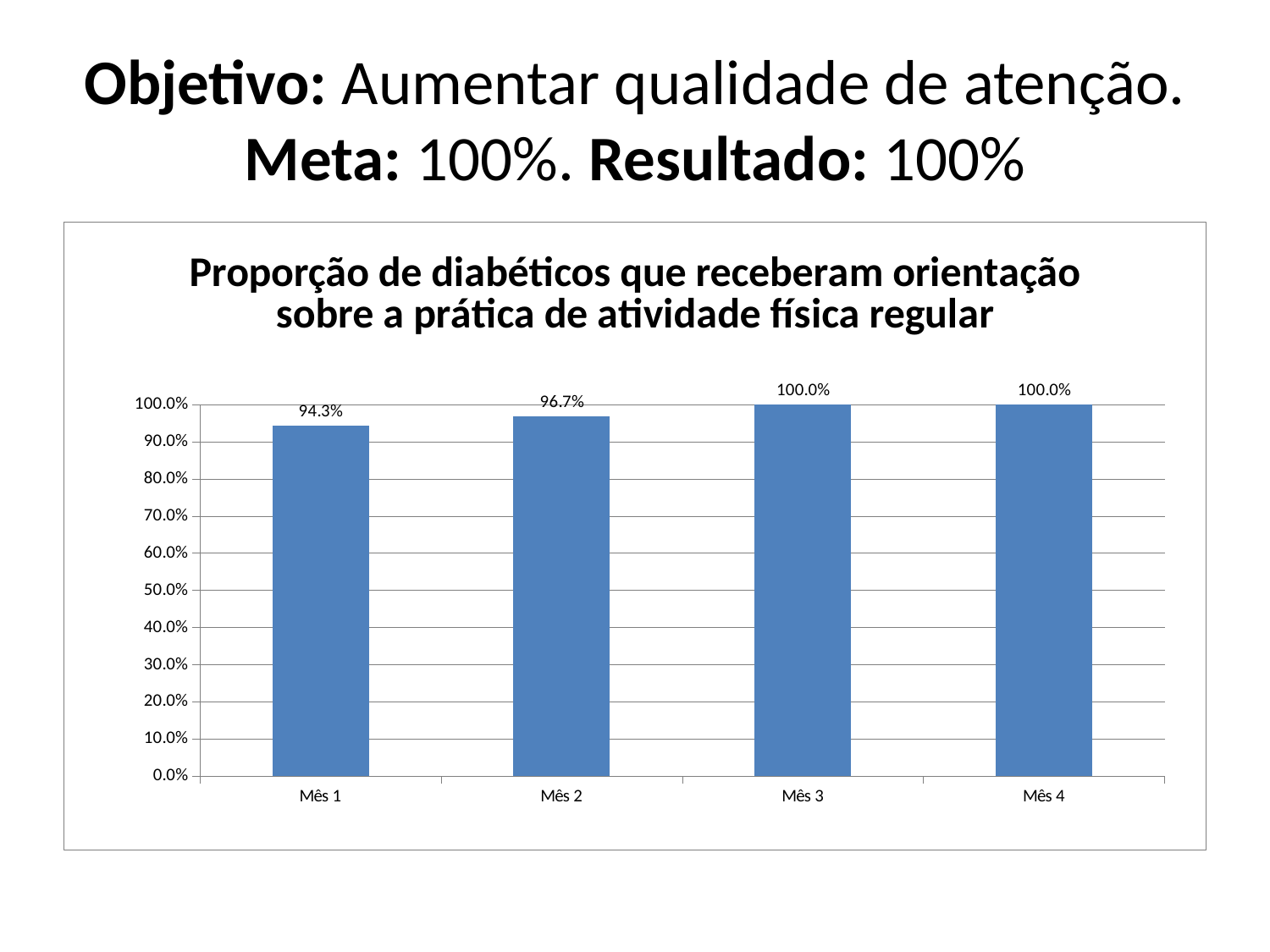
What is the difference between the values for Mês 2 and Mês 1? 2.4% What is the value for Mês 4? 100.0% Which month has the lowest value? Mês 1 How many months are shown on the x axis? 4 What kind of chart is shown on the slide? bar chart Is the value for Mês 1 greater or less than 90.0%? greater What is the value for Mês 1? 94.3% What is the difference between the values for Mês 3 and Mês 2? 3.3% Which is larger, the value for Mês 1 or the value for Mês 2? Mês 2 What is the value for Mês 3? 100.0% What is the value for Mês 2? 96.7% Do the values rise or fall from Mês 1 to Mês 3? rise